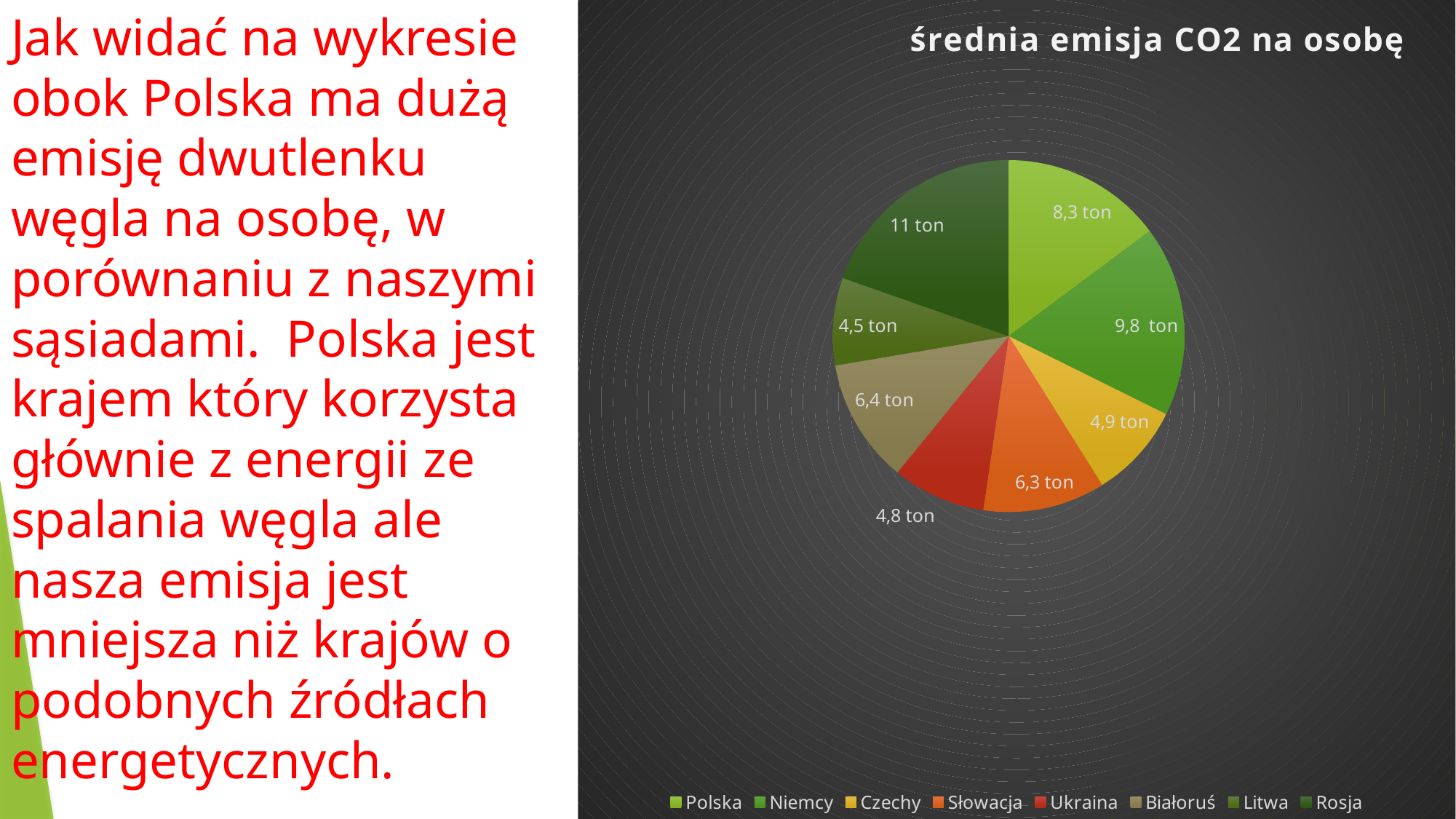
Which country has the lowest CO2 emission per person? Litwa Which country has the highest CO2 emission per person? Rosja How many countries are shown in the pie chart? 8 What is the value for Litwa? 4,5 ton What kind of chart is shown on the slide? pie chart What is the value for Rosja? 11 ton What is the value for Niemcy? 9,8 ton What is the value for Polska? 8,3 ton Which is larger, the value for Niemcy or the value for Słowacja? Niemcy What is the difference between the values for Rosja and Polska? 2,7 ton What is the title of the chart? średnia emisja CO2 na osobę Which legend entry is shown in red? Ukraina